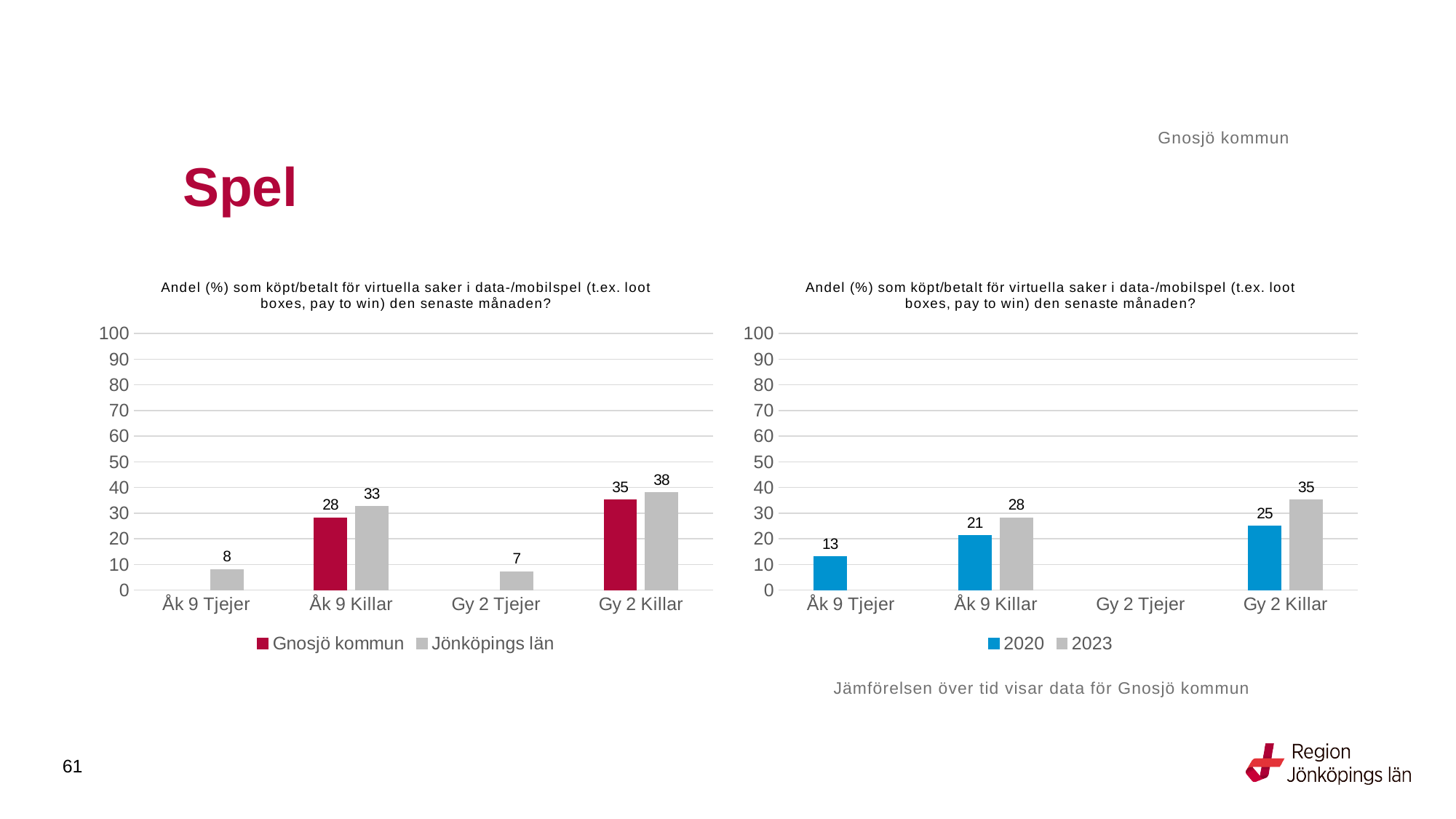
In the right chart, what is the difference between 2023 and 2020 for Åk 9 Killar? 7 How many series does the legend of the right chart list? 2 In the left chart, what is the value for Gnosjö kommun for Gy 2 Killar? 35 In the left chart, what is the value for Jönköpings län for Åk 9 Killar? 33 In the left chart, what is the value for Jönköpings län for Gy 2 Tjejer? 7 In the left chart, what is the difference between Jönköpings län and Gnosjö kommun for Gy 2 Killar? 3 In the right chart, what is the value for 2023 for Gy 2 Killar? 35 What kind of chart is the left chart? Bar chart In the right chart, which category has the lowest value for 2020? Åk 9 Tjejer In the right chart, what is the value for 2020 for Åk 9 Tjejer? 13 In the left chart, which category has the highest value for Jönköpings län? Gy 2 Killar In the left chart, which is larger for Åk 9 Killar: Gnosjö kommun or Jönköpings län? Jönköpings län